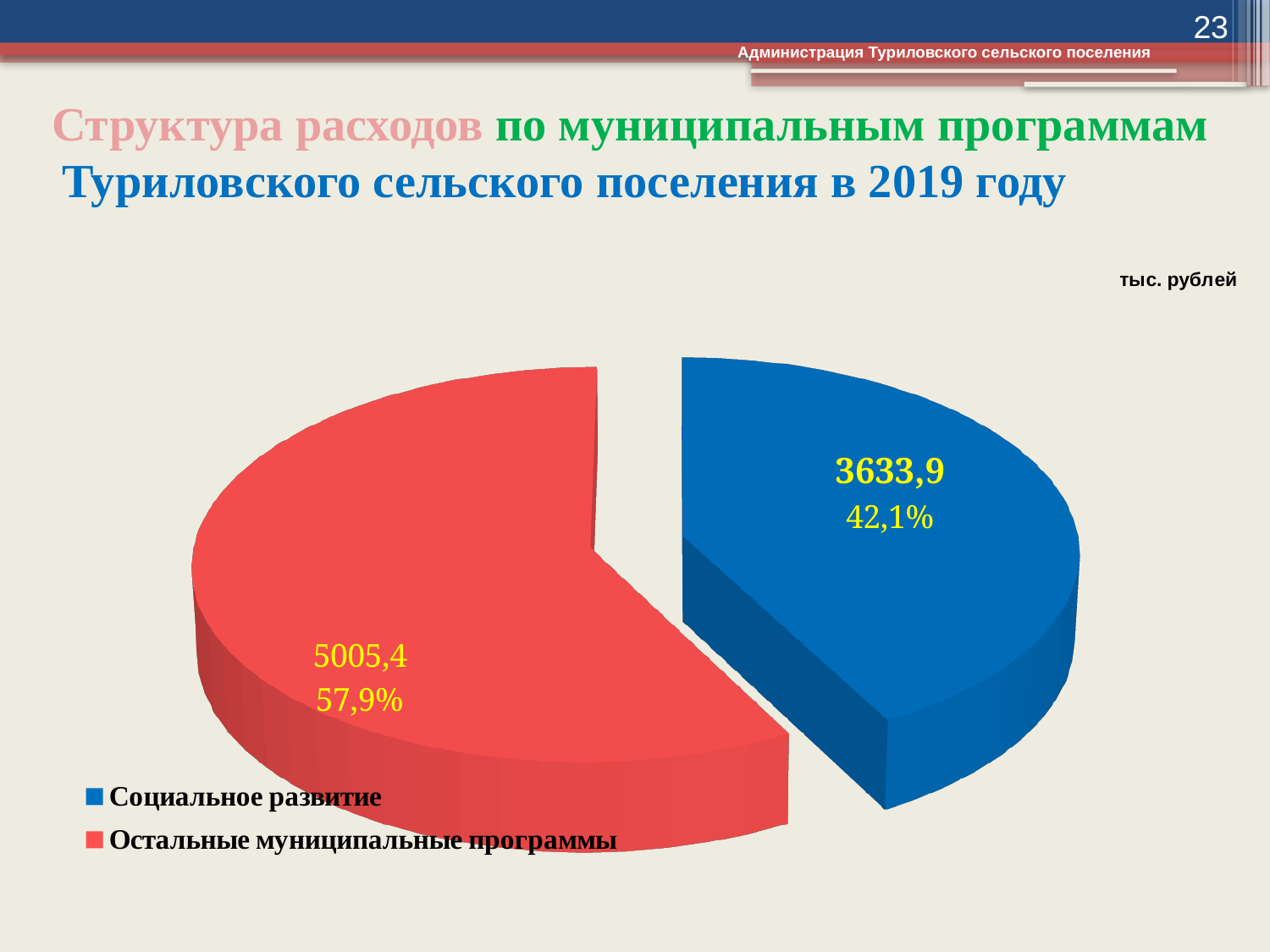
What colour is the slice for Социальное развитие? blue What is the value for Остальные муниципальные программы? 5005,4 Which is larger: Социальное развитие or Остальные муниципальные программы? Остальные муниципальные программы What is the difference between the values for Остальные муниципальные программы and Социальное развитие? 1371,5 How many slices does the pie chart have? 2 What is the total of the two slices? 8639,3 What share of the pie does Социальное развитие take? 42,1% What share of the pie does Остальные муниципальные программы take? 57,9% What kind of chart is shown on the slide? pie chart Which slice is the largest? Остальные муниципальные программы What is the value for Социальное развитие? 3633,9 Which slice is the smallest? Социальное развитие